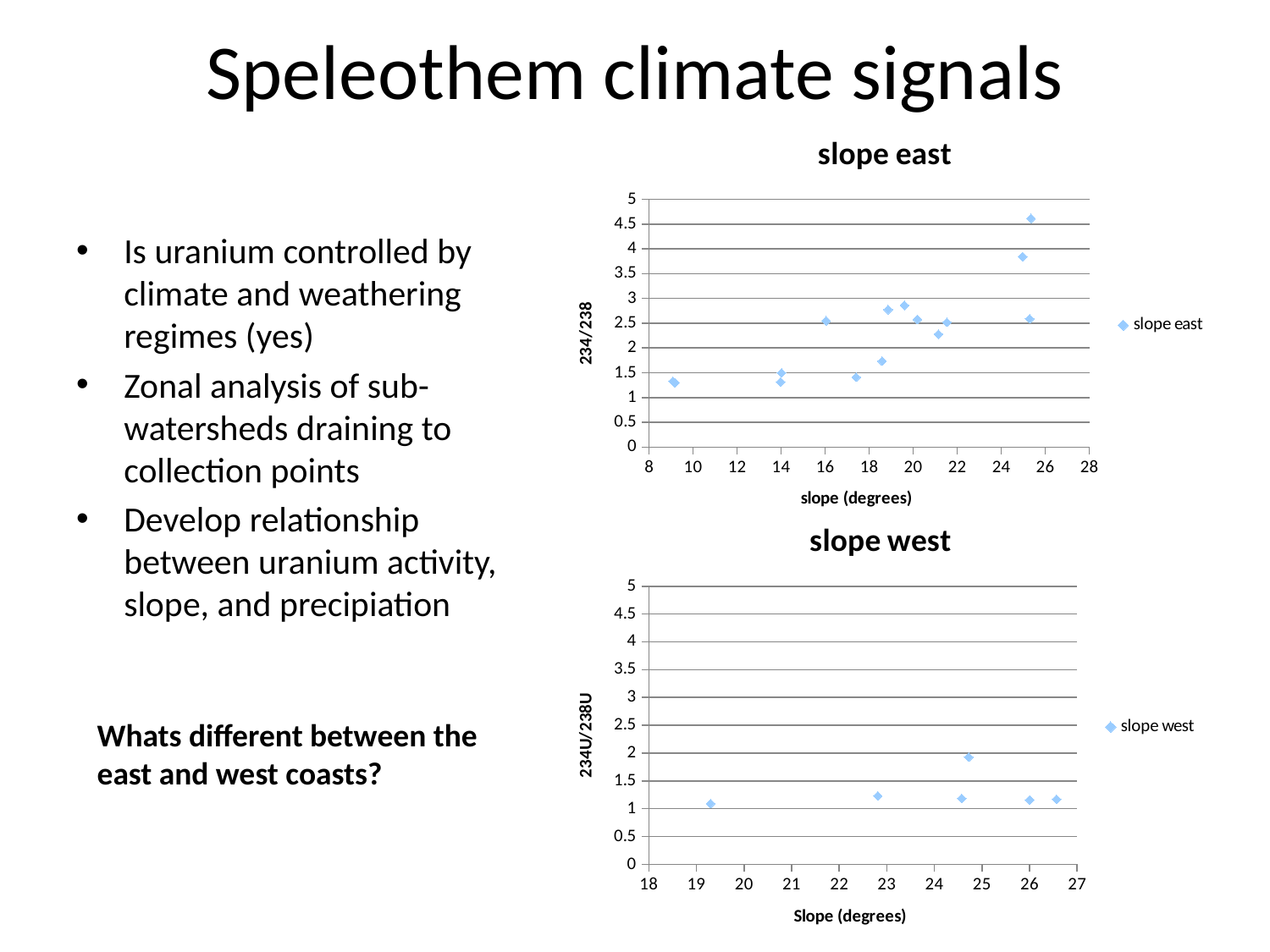
How many series does the legend of the "slope west" chart list? 1 What kind of chart is the "slope west" chart? scatter chart What kind of chart is the "slope east" chart? scatter chart How many data points are plotted in the "slope west" chart? 6 Which chart has the higher maximum plotted value, "slope east" or "slope west"? slope east What is the x-axis label of the "slope east" chart? slope (degrees) In the "slope west" chart, is the value of the point at a slope of about 19 degrees greater or less than 1.5? less In the "slope west" chart, is the highest plotted 234U/238U value greater or less than 2.5? less In the "slope east" chart, is the value of the point at a slope of about 9 degrees greater or less than 2? less How many series does the legend of the "slope east" chart list? 1 What is the y-axis label of the "slope west" chart? 234U/238U